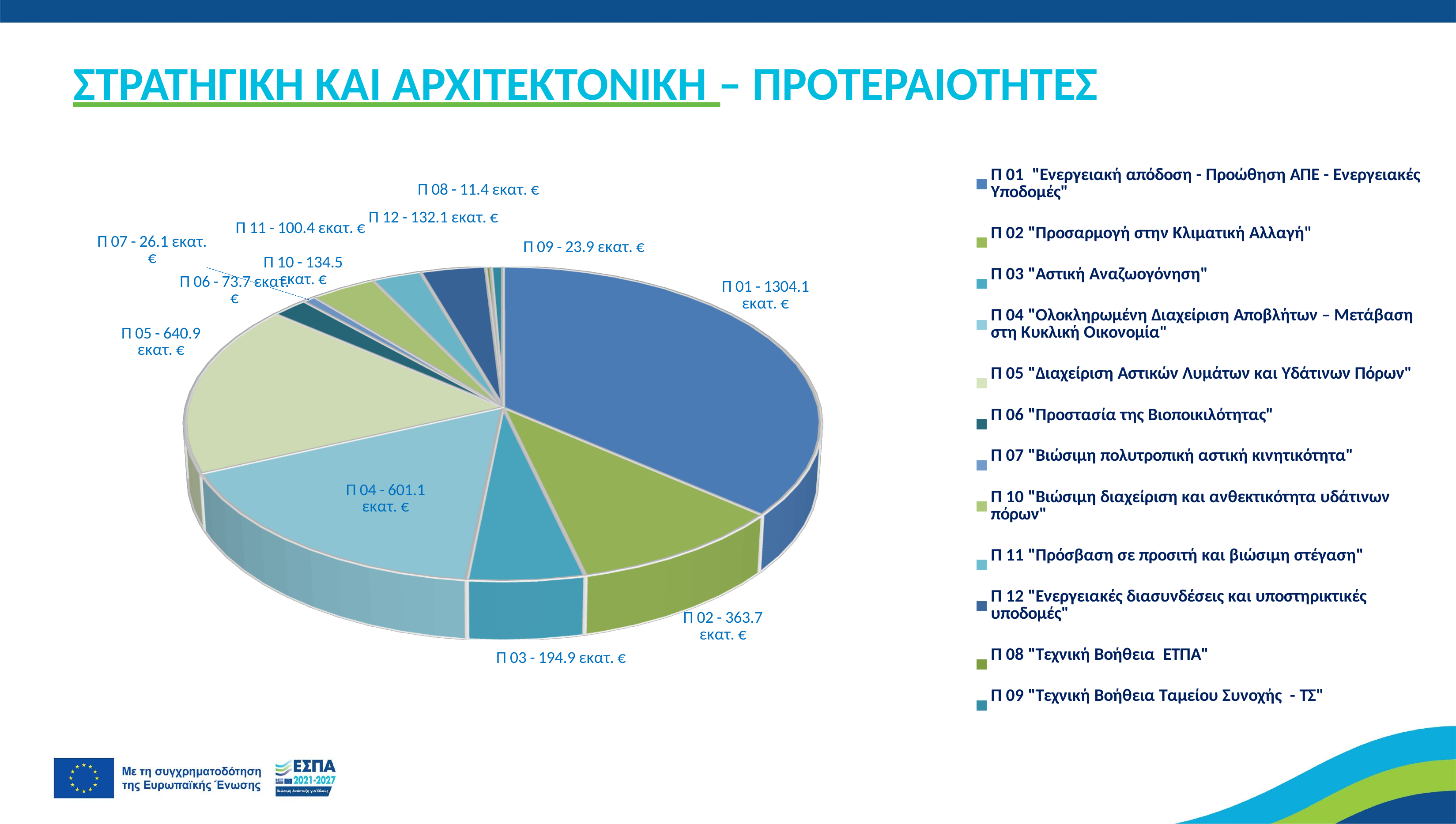
What is the value shown for Π 12 in the pie chart? 132.1 εκατ. € Which has a larger value, Π 05 or Π 04? Π 05 Which priority has the smallest slice in the pie chart? Π 08 What is the difference between the values of Π 05 and Π 04? 39.8 εκατ. € What is the value shown for Π 04 in the pie chart? 601.1 εκατ. € What is the difference between the values of Π 01 and Π 02? 940.4 εκατ. € What kind of chart is shown on the slide? Pie chart How many slices does the pie chart have? 12 How many entries does the legend of the pie chart list? 12 Which priority has the largest slice in the pie chart? Π 01 What is the value shown for Π 09 in the pie chart? 23.9 εκατ. € What is the value shown for Π 01 in the pie chart? 1304.1 εκατ. €